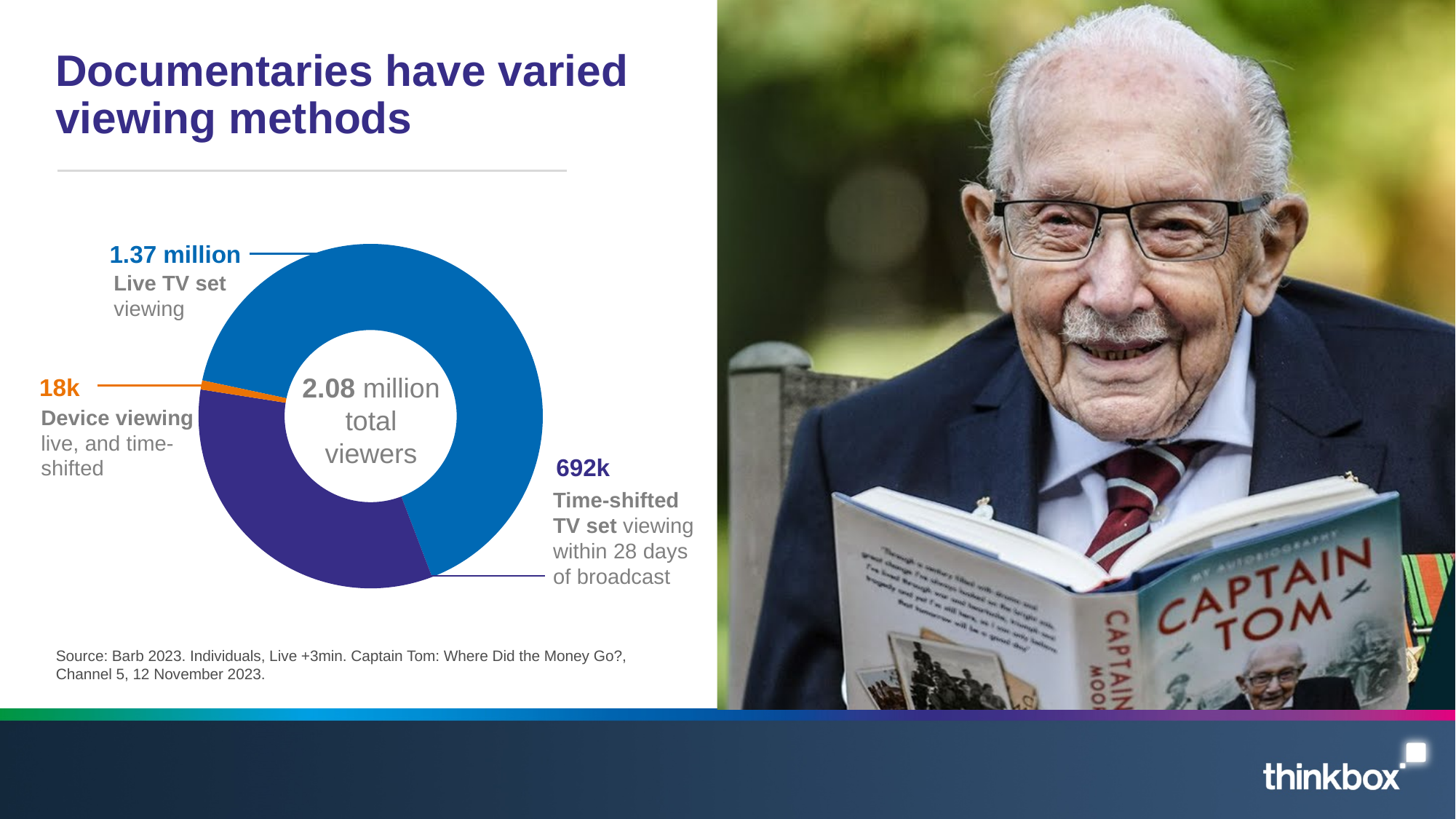
What is the value for Device viewing (live, and time-shifted)? 18k What colour is the segment for Device viewing? Orange Which is larger, Time-shifted TV set viewing or Device viewing? Time-shifted TV set viewing What is the difference between Time-shifted TV set viewing and Device viewing? 674k Which viewing method has the highest number of viewers? Live TV set viewing What is the title of the slide? Documentaries have varied viewing methods What kind of chart is used on the slide? Doughnut chart Which viewing method has the lowest number of viewers? Device viewing What is the value for Time-shifted TV set viewing within 28 days of broadcast? 692k How many viewing methods (segments) does the chart show? 3 What is the total number of viewers shown in the centre of the chart? 2.08 million What is the value for Live TV set viewing? 1.37 million